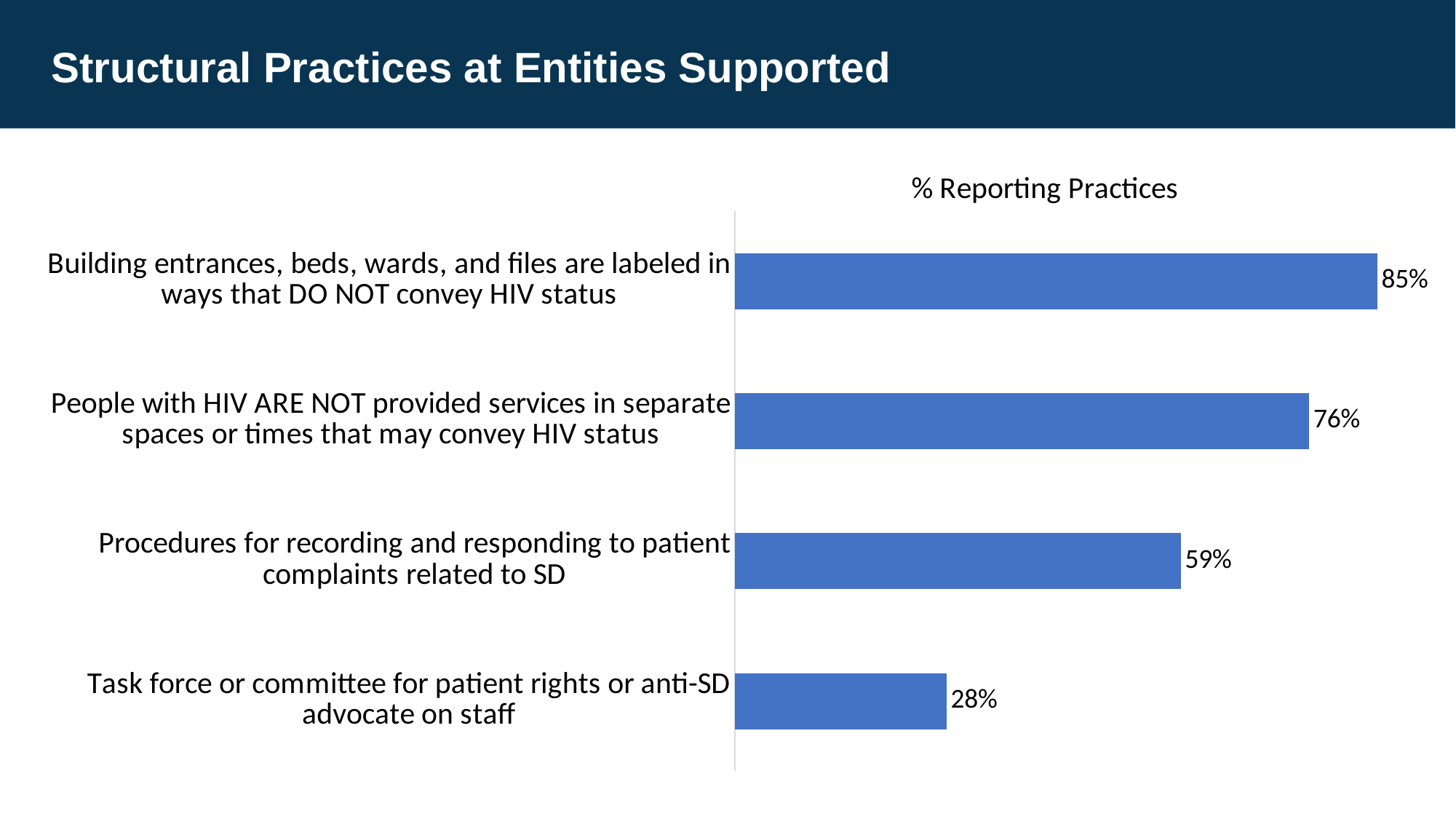
What percentage of entities reported having procedures for recording and responding to patient complaints related to SD? 59% What is the difference in percentage points between the practice of labeling that does not convey HIV status and having a task force or anti-SD advocate on staff? 57 percentage points What type of chart is shown on the slide? Bar chart Which structural practice has the highest percentage of entities reporting it? Building entrances, beds, wards, and files are labeled in ways that DO NOT convey HIV status What percentage of entities reported having a task force or committee for patient rights or anti-SD advocate on staff? 28% Which structural practice has the lowest percentage of entities reporting it? Task force or committee for patient rights or anti-SD advocate on staff What is the difference in percentage points between not providing services in separate spaces or times and having procedures for recording and responding to SD complaints? 17 percentage points How many structural practices are shown in the chart? 4 What percentage of entities reported that building entrances, beds, wards, and files are labeled in ways that DO NOT convey HIV status? 85% What is the title of the chart? % Reporting Practices What percentage of entities reported that people with HIV ARE NOT provided services in separate spaces or times that may convey HIV status? 76% Which is reported by a larger share of entities: procedures for recording and responding to patient complaints related to SD, or a task force or committee for patient rights or anti-SD advocate on staff? Procedures for recording and responding to patient complaints related to SD